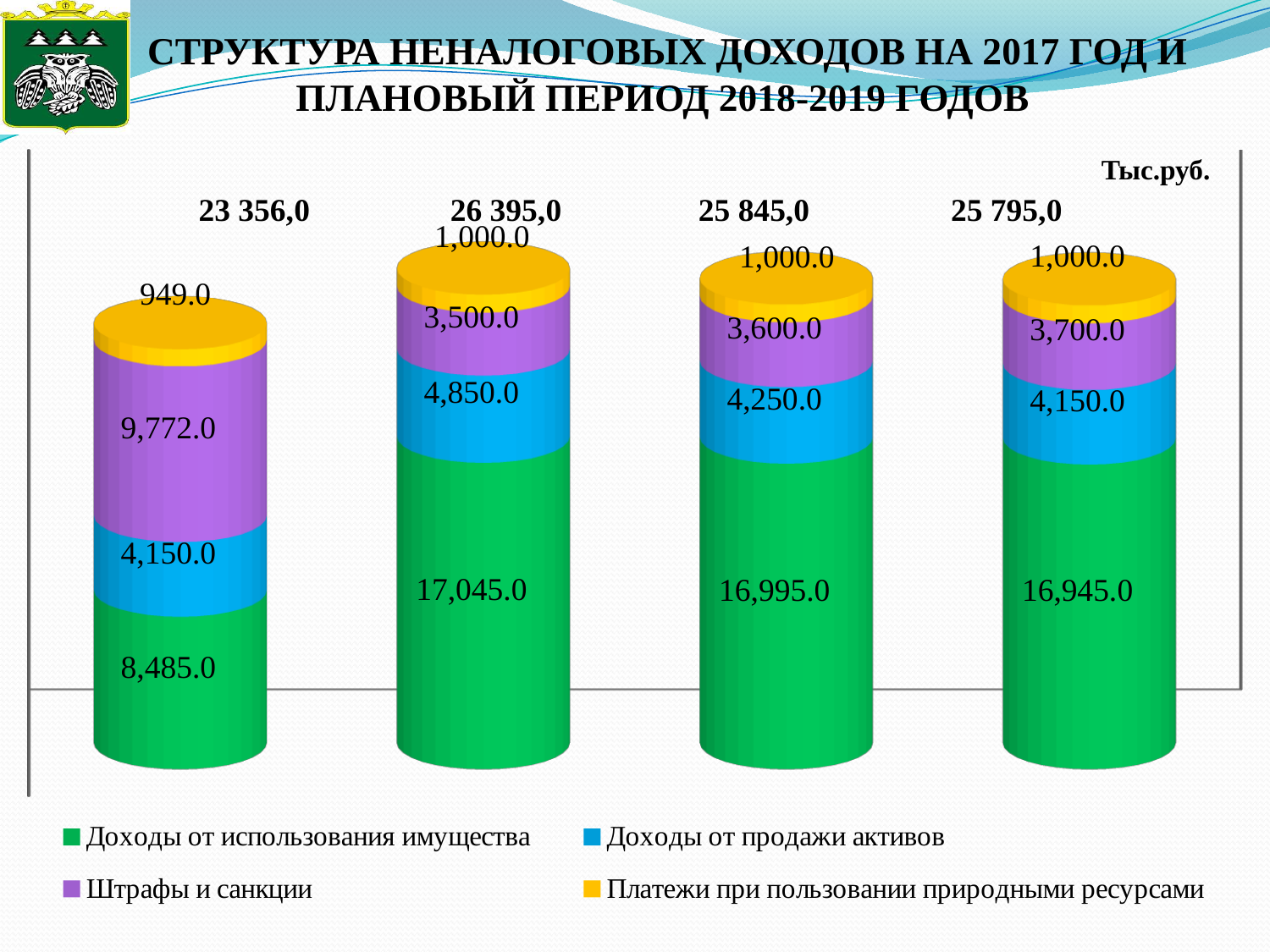
How many stacked bars are plotted in the chart? 4 How many series does the legend list? 4 What is the difference between the green segment values of the second bar (17,045.0) and the fourth bar (16,945.0)? 100.0 What is the value of the blue segment (Доходы от продажи активов) in the second bar from the left? 4,850.0 Which bar has the highest printed total? the second bar from the left (26 395,0) What kind of chart is shown on the slide? stacked bar chart Which bar has the lowest printed total? the first bar from the left (23 356,0) What is the value of the purple segment (Штрафы и санкции) in the first bar from the left? 9,772.0 Which is larger: the purple segment in the third bar or the purple segment in the fourth bar? the fourth bar (3,700.0) What total is printed above the second bar from the left? 26 395,0 What is the value of the yellow segment (Платежи при пользовании природными ресурсами) in the first bar from the left? 949.0 What is the value of the green segment (Доходы от использования имущества) in the first bar from the left? 8,485.0